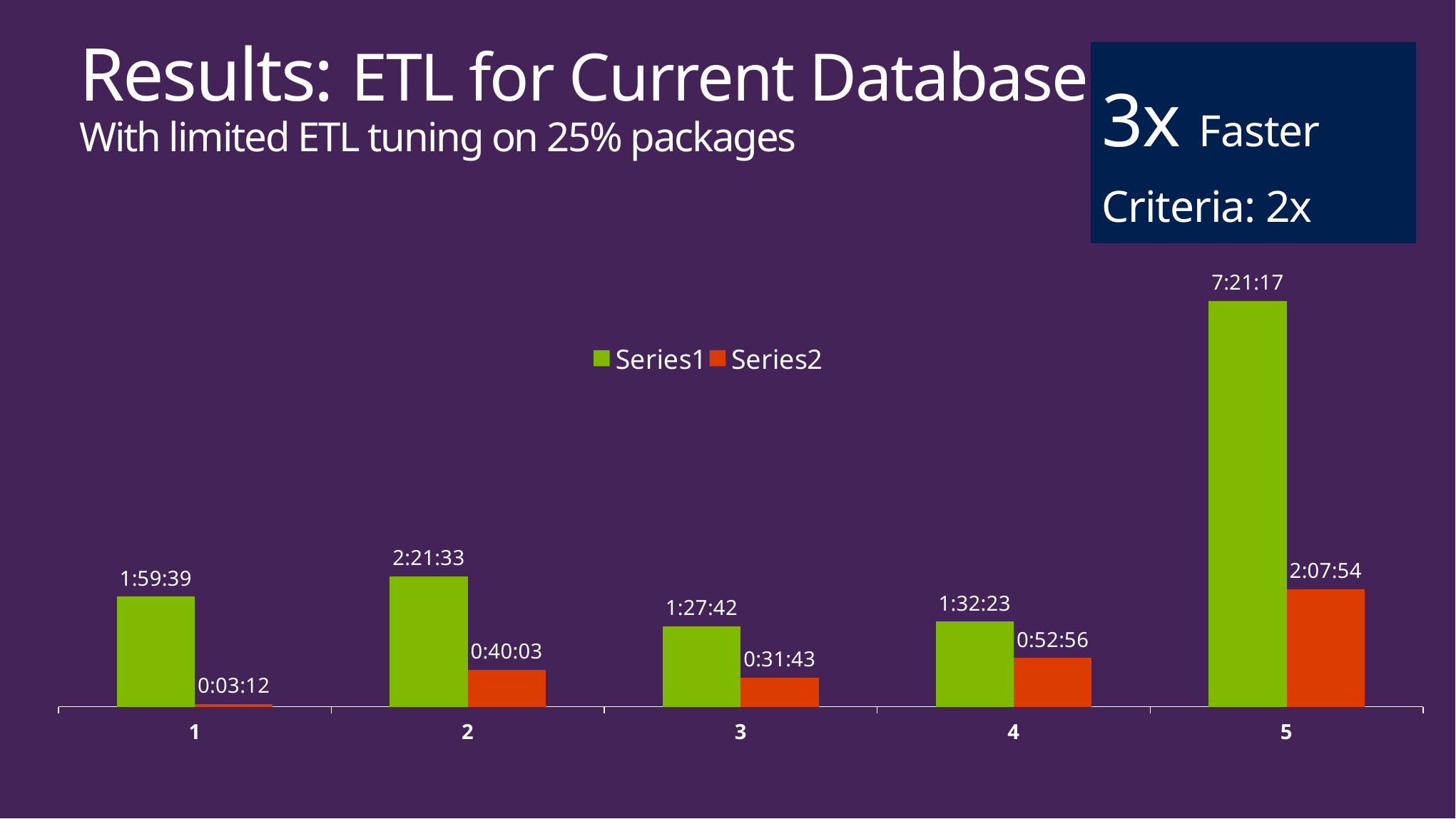
What is the Series2 value for category 4? 0:52:56 Which category has the highest Series1 value? 5 What is the Series2 value for category 1? 0:03:12 Which category has the lowest Series1 value? 3 What kind of chart is shown on the slide? Bar chart How many series does the legend list? 2 How many categories are shown on the x axis? 5 What is the difference between the Series1 and Series2 values for category 5? 5:13:23 Which category has the lowest Series2 value? 1 Which is larger for category 2, Series1 or Series2? Series1 What is the Series1 value for category 3? 1:27:42 What is the Series1 value for category 5? 7:21:17